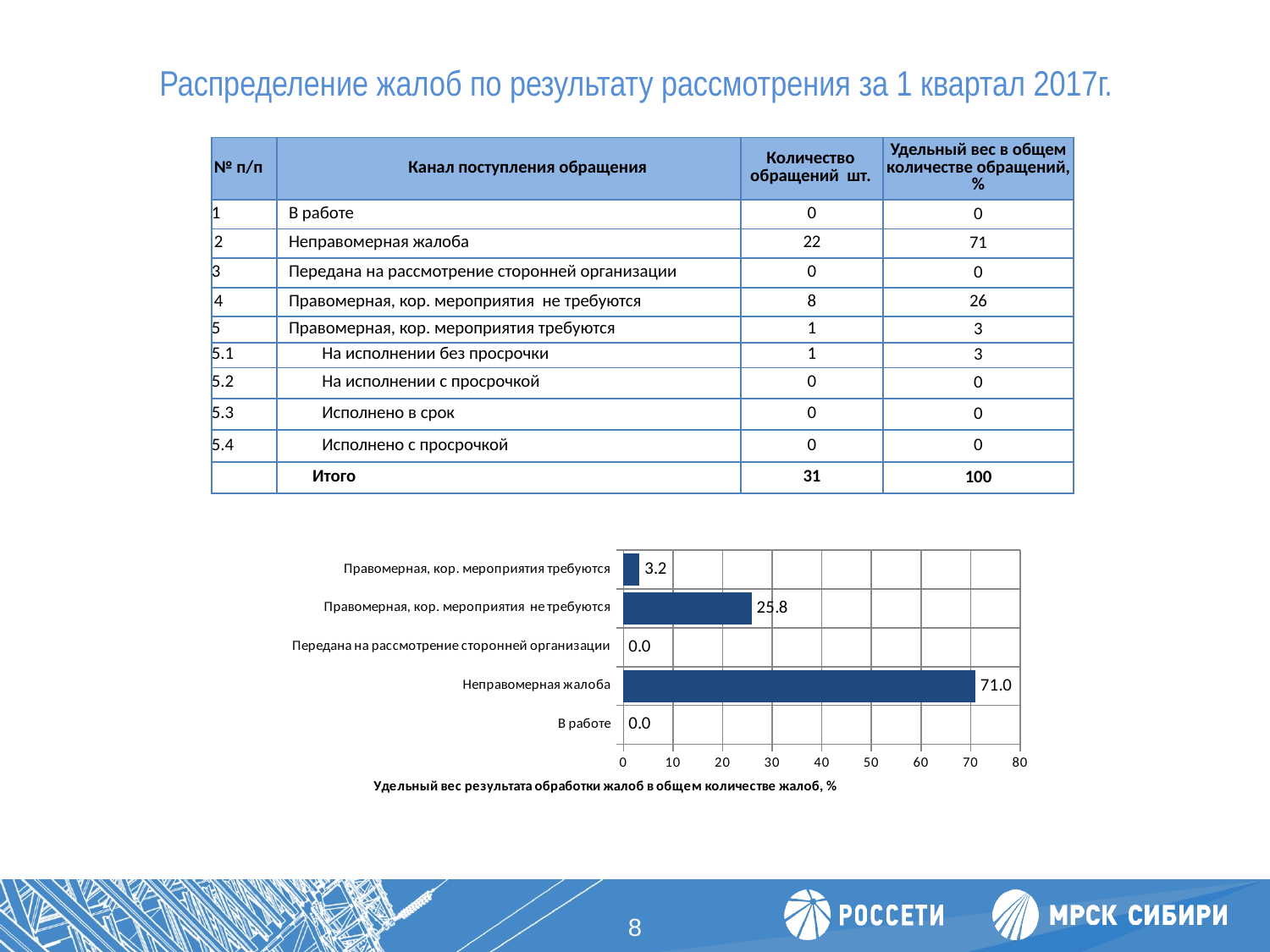
How many categories in the bar chart have a value of 0.0? 2 What is the title printed below the bar chart? Удельный вес результата обработки жалоб в общем количестве жалоб, % What is the difference between the values for "Неправомерная жалоба" and "Правомерная, кор. мероприятия не требуются" in the bar chart? 45.2 Which category has the highest value in the bar chart? Неправомерная жалоба What is the value for "Неправомерная жалоба" in the bar chart? 71.0 What is the value for "Правомерная, кор. мероприятия не требуются" in the bar chart? 25.8 How many categories are shown in the bar chart? 5 Which is larger in the bar chart: the value for "Правомерная, кор. мероприятия требуются" or for "Правомерная, кор. мероприятия не требуются"? Правомерная, кор. мероприятия не требуются What is the value for "В работе" in the bar chart? 0.0 What type of chart is shown on the slide? bar chart Is the value for "Неправомерная жалоба" in the bar chart greater or less than 60? greater What is the value for "Правомерная, кор. мероприятия требуются" in the bar chart? 3.2